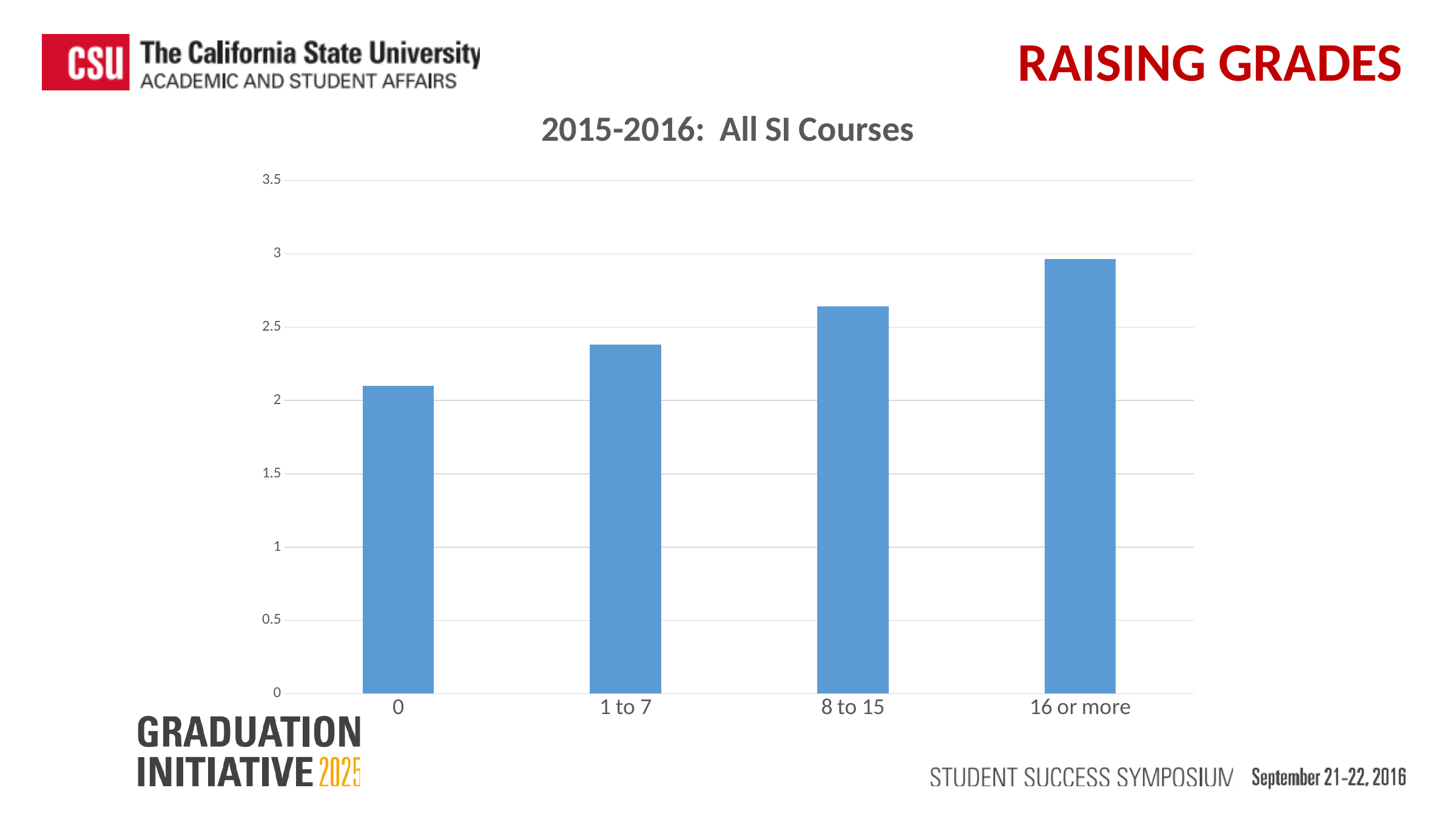
Is the value for the "0" category greater or less than 2? greater Do the bar values rise or fall moving from left to right along the x axis? rise What is the highest value labelled on the y axis? 3.5 Which category has the lowest bar? 0 Is the value for "1 to 7" greater or less than 2.5? less Is the value for "8 to 15" greater or less than 2.5? greater Which category has the highest bar? 16 or more Which is larger, the value for "8 to 15" or the value for "1 to 7"? 8 to 15 How many categories are shown on the x axis of the chart? 4 What kind of chart is shown on the slide? bar chart What is the title of the chart? 2015-2016: All SI Courses